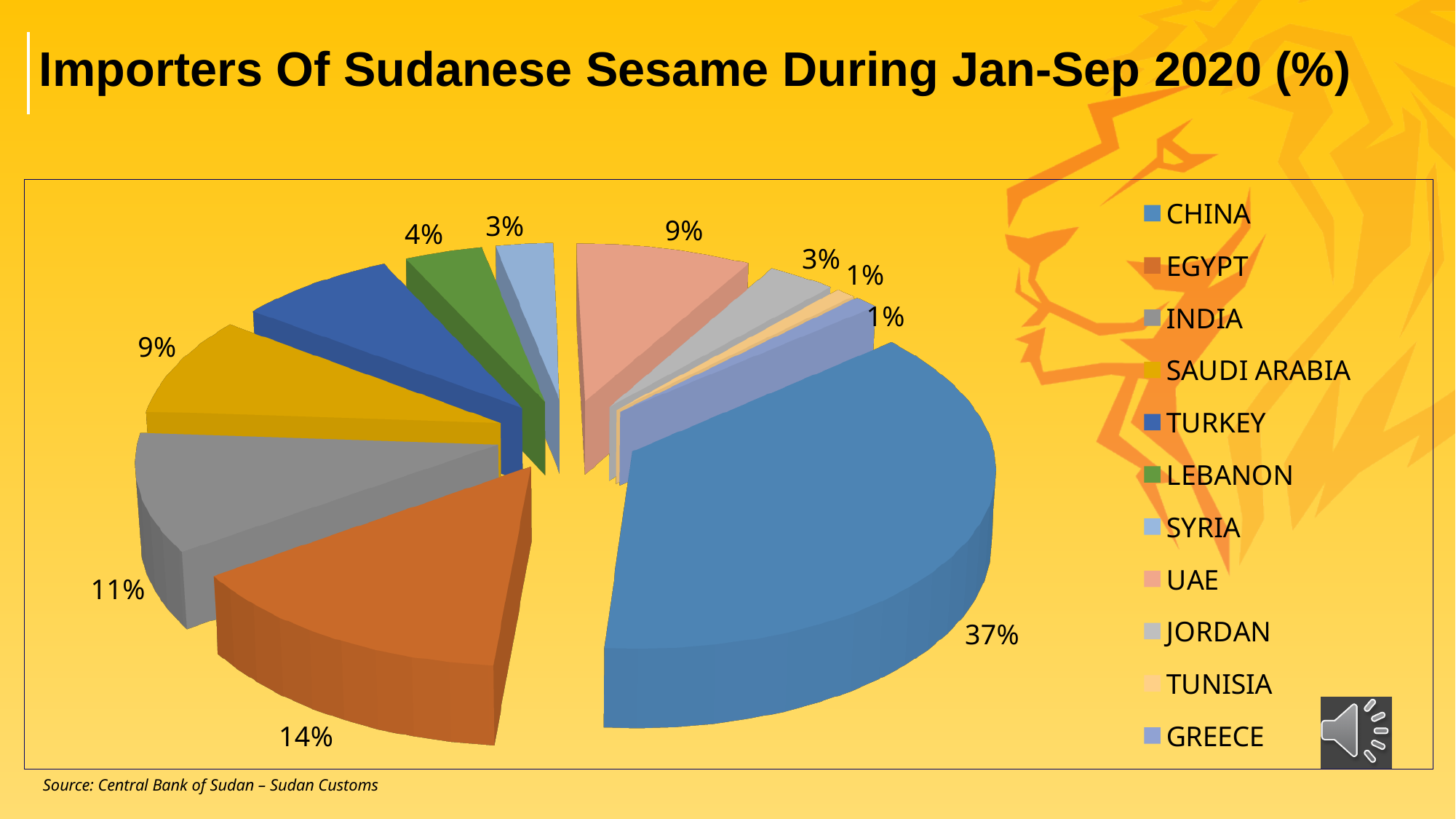
Which country has the largest share of Sudanese sesame imports? China What share of Sudanese sesame imports does China account for? 37% How many countries are listed in the legend of the pie chart? 11 Which two countries have the smallest share, at 1% each? Tunisia and Greece What is Syria's share of Sudanese sesame imports? 3% What is the difference in percentage points between China's share and Egypt's share? 23 What is the UAE's share of Sudanese sesame imports? 9% What is Egypt's share of Sudanese sesame imports? 14% What kind of chart is shown on the slide? Pie chart What is the title of the chart? Importers Of Sudanese Sesame During Jan-Sep 2020 (%) What is India's share of Sudanese sesame imports? 11% Which has a larger share, Egypt or India? Egypt